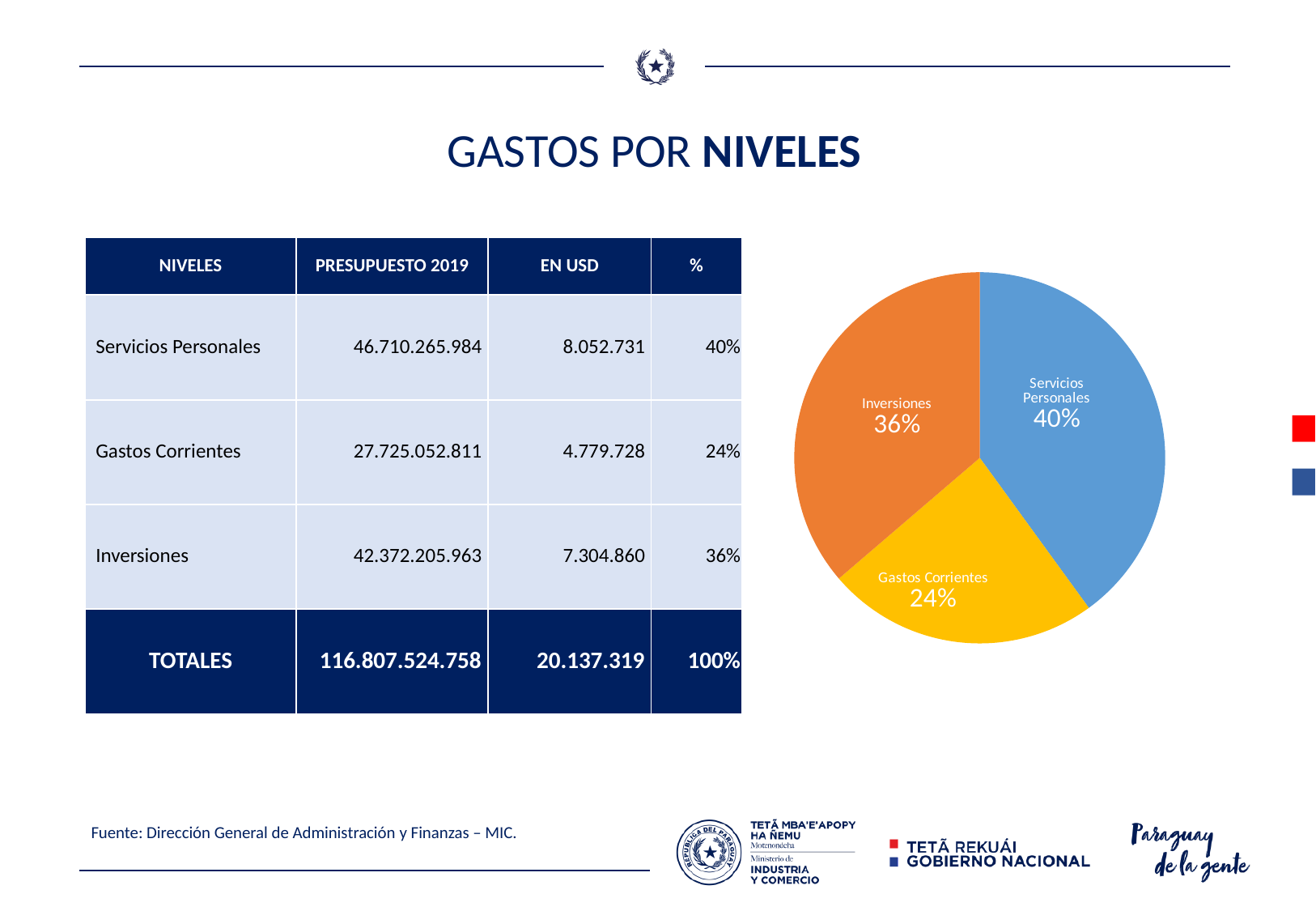
What share of the pie does Gastos Corrientes represent? 24% What kind of chart is shown on the slide? pie chart What share of the pie does Servicios Personales represent? 40% What is the difference in percentage points between the Servicios Personales slice and the Gastos Corrientes slice? 16% Which slice of the pie chart is the smallest? Gastos Corrientes What share of the pie does Inversiones represent? 36% What colour is the Gastos Corrientes slice in the pie chart? yellow What is the difference in percentage points between the Servicios Personales slice and the Inversiones slice? 4% How many slices does the pie chart have? 3 What colour is the Inversiones slice in the pie chart? orange Which slice of the pie chart is the largest? Servicios Personales Which slice is larger, Inversiones or Gastos Corrientes? Inversiones